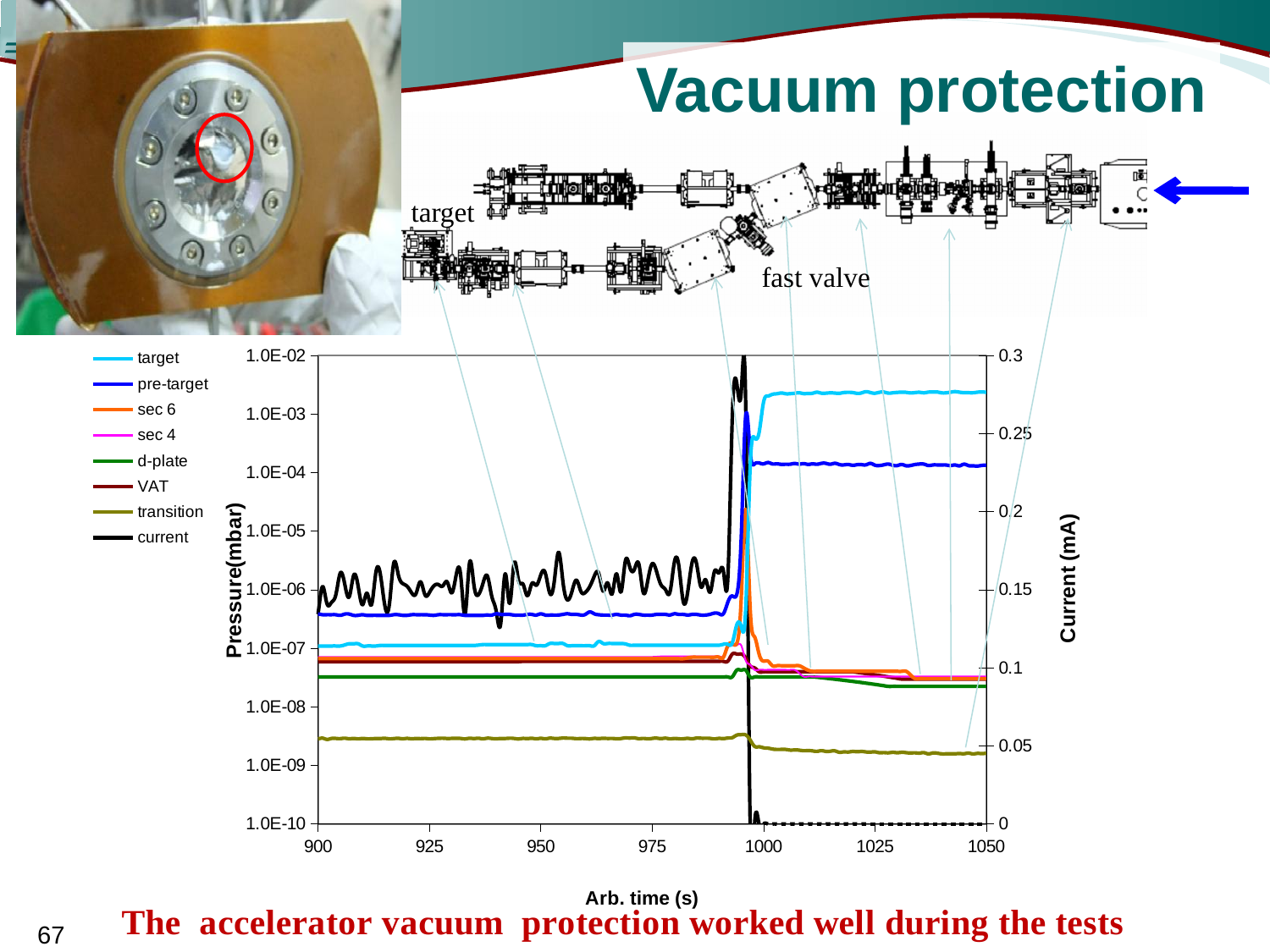
Which series has the lowest pressure at 1050 s? transition What is the label of the right-hand y axis of the chart? Current (mA) Does the current rise or fall after about 1000 s? fall At 950 s, is the pressure for transition greater or less than 1.0E-08 mbar? less What is the maximum value shown on the right-hand Current axis? 0.3 What is the label of the x axis of the chart? Arb. time (s) At 1050 s, is the pressure for target greater or less than 1.0E-03 mbar? greater Which series has the highest pressure at 1050 s? target At 1025 s, is the current greater or less than 0.05 mA? less At 1025 s, which series has the higher pressure, target or pre-target? target What kind of chart is shown on the slide? line chart How many series does the chart legend list? 8